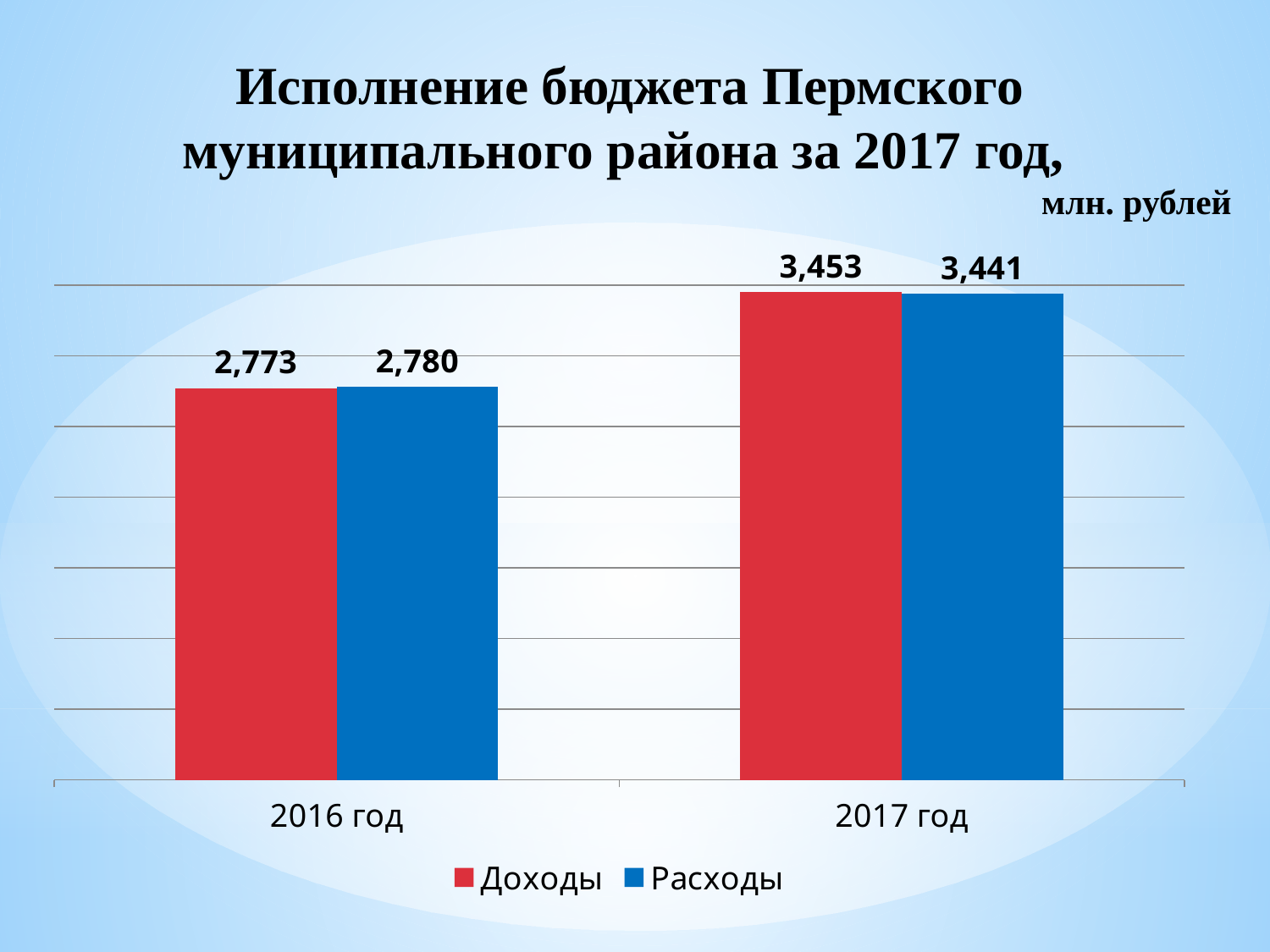
By how much did Доходы increase from 2016 год to 2017 год? 680 Which colour represents Расходы in the chart? blue What is the difference between Доходы and Расходы in 2017 год? 12 Is Расходы for 2017 год larger or smaller than Расходы for 2016 год? larger Which year has the lower value for Расходы? 2016 год What is the value of Расходы for 2016 год? 2,780 What is the value of Доходы for 2016 год? 2,773 How many series does the legend list? 2 What is the value of Расходы for 2017 год? 3,441 What is the value of Доходы for 2017 год? 3,453 Which year has the higher value for Доходы? 2017 год What kind of chart is shown on the slide? bar chart